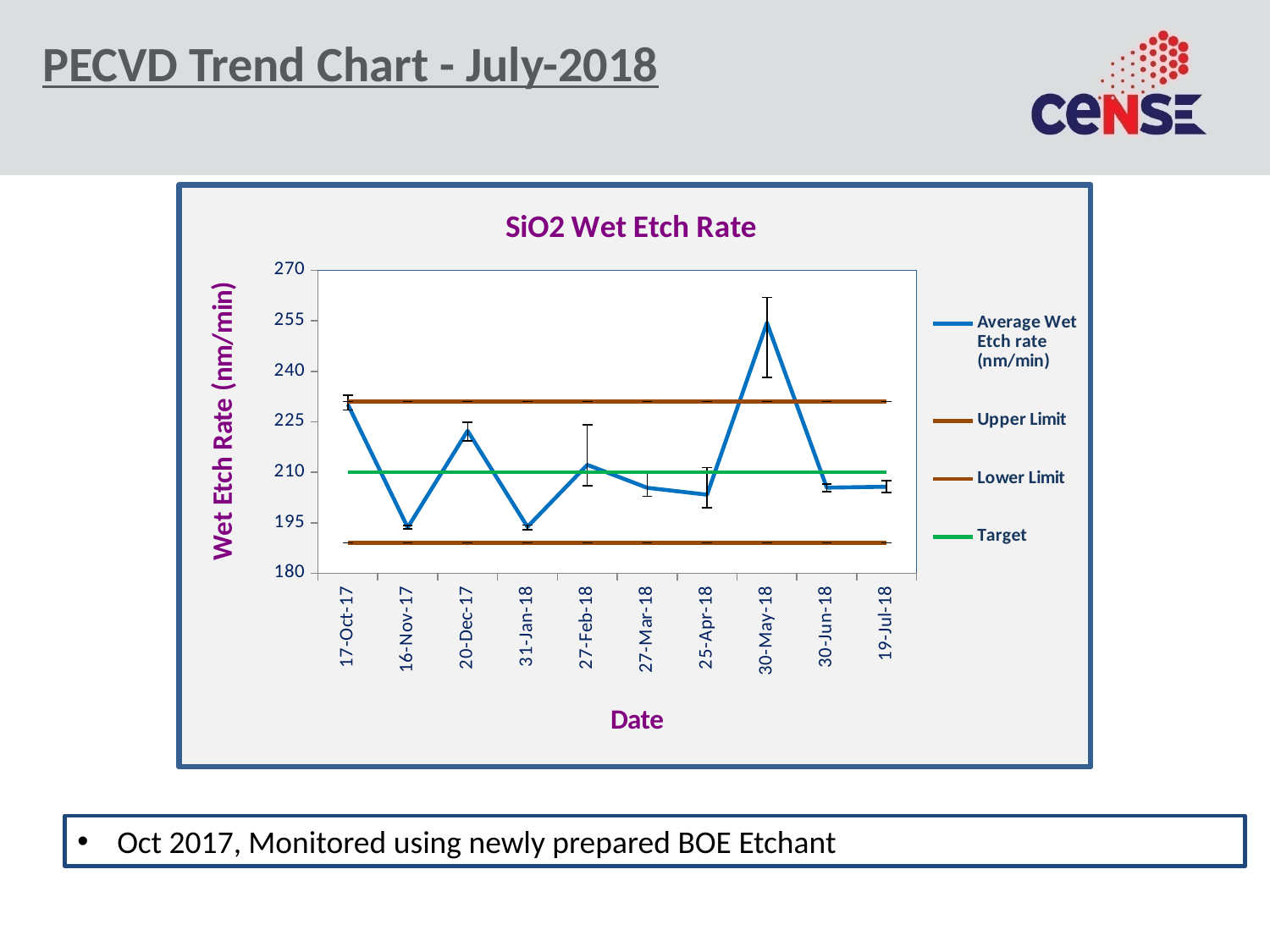
What is the label of the y axis? Wet Etch Rate (nm/min) Which has the larger Average Wet Etch rate, 30-May-18 or 30-Jun-18? 30-May-18 At what value does the Target line sit on the y axis? 210 Does the Average Wet Etch rate rise or fall from 30-May-18 to 30-Jun-18? Fall Is the Average Wet Etch rate for 30-May-18 greater or less than 240? greater On which date is the Average Wet Etch rate highest? 30-May-18 How many series does the chart legend list? 4 Is the Average Wet Etch rate for 20-Dec-17 greater or less than 210? greater How many dates are plotted along the x axis? 10 What kind of chart is shown on the slide? Line chart What is the title of the chart? SiO2 Wet Etch Rate Is the Average Wet Etch rate for 16-Nov-17 greater or less than 210? less